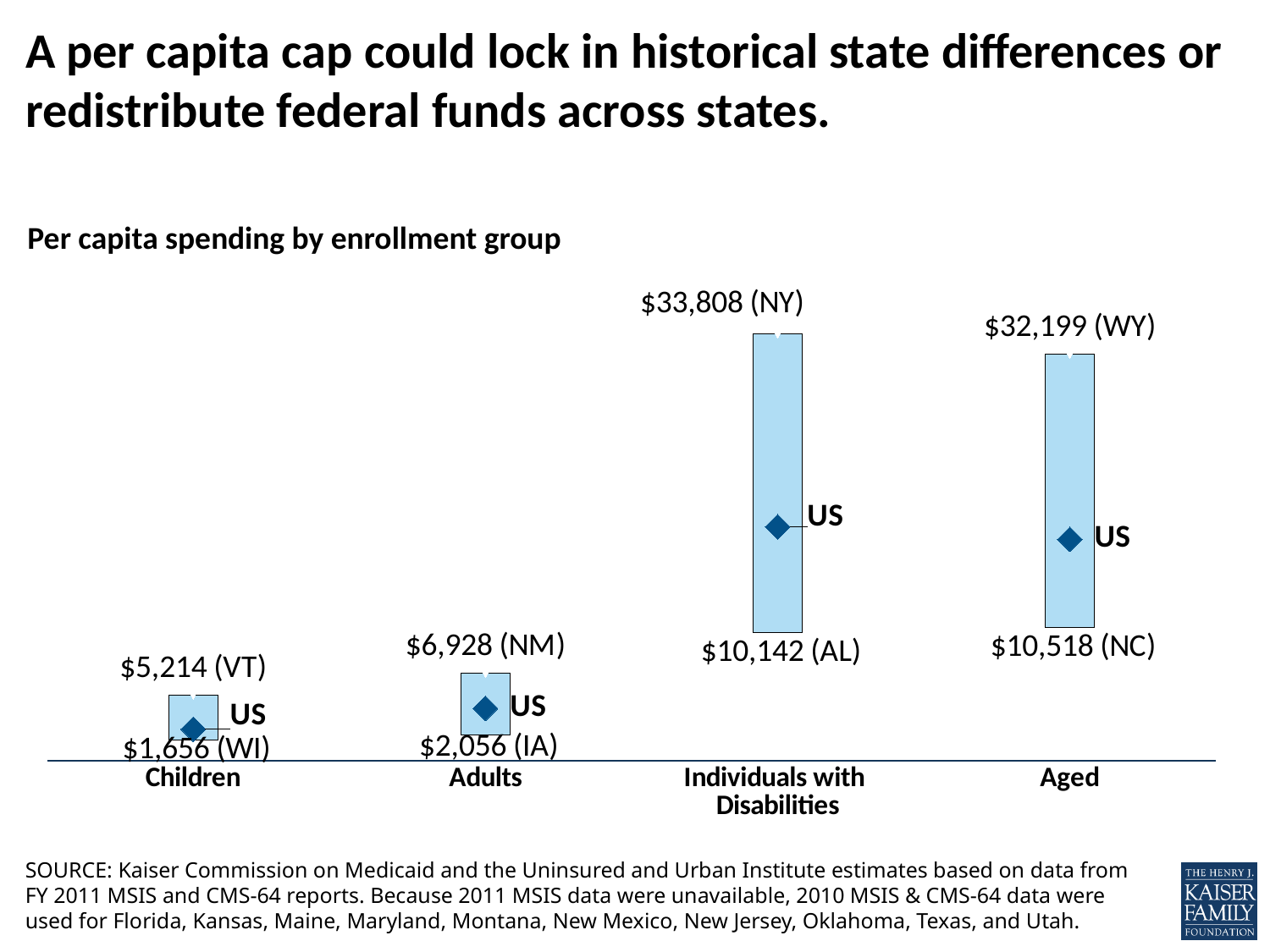
What is the difference between the highest and lowest values shown for Individuals with Disabilities? $23,666 What is the difference between the highest and lowest values shown for Children? $3,558 What is the lowest per capita spending value shown for Aged? $10,518 (NC) What is the lowest per capita spending value shown for Adults, and which state is it? $2,056 (IA) What is the highest per capita spending value shown for Individuals with Disabilities? $33,808 (NY) What kind of chart is shown on the slide? Bar chart What is the highest per capita spending value shown for Children, and which state is it? $5,214 (VT) Which enrollment group has the highest top value shown on the chart? Individuals with Disabilities How many enrollment groups are shown on the x axis? 4 Which enrollment group has the lowest bottom value shown on the chart? Children What does the diamond marker inside each bar represent? US Which is larger: the top value for Aged or the top value for Individuals with Disabilities? Individuals with Disabilities